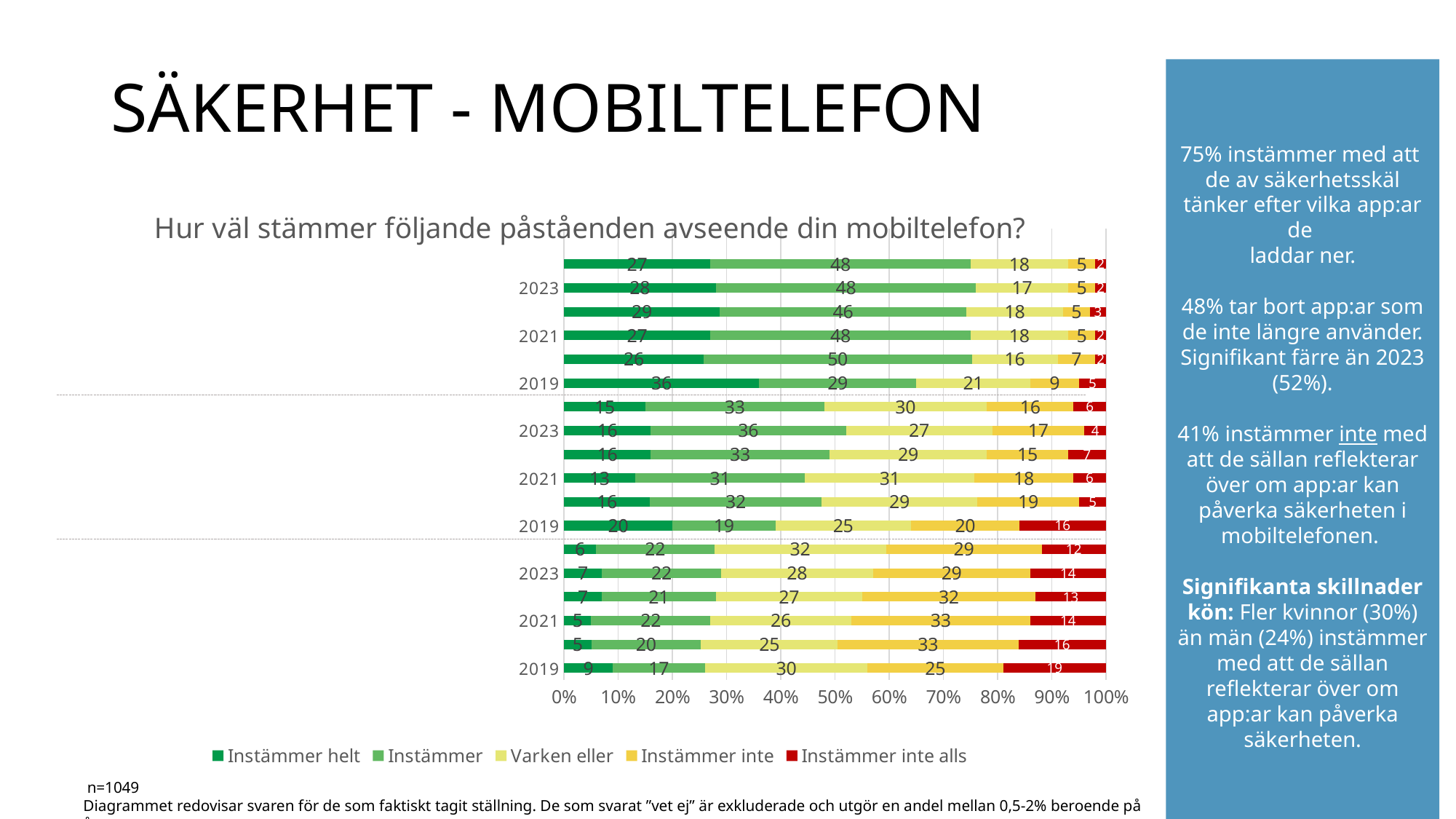
In the top group of bars, what is the 'Instämmer' value for 2023? 48 In the middle group of bars, what is the difference between the 'Instämmer inte alls' values for 2019 and 2023? 12 How many stacked bars are plotted in the chart in total? 18 In the bottom group of bars, what is the 'Instämmer inte alls' value for 2019? 19 Which legend entry is shown in dark red? Instämmer inte alls In the top group of bars, which is larger for 2019: 'Instämmer helt' or 'Instämmer'? Instämmer helt In the bottom group of bars, what is the 'Instämmer inte' value for 2021? 33 In the bottom group of bars, which year has the highest 'Instämmer inte alls' value? 2019 In the middle group of bars, what is the 'Varken eller' value for 2021? 31 How many series does the legend list? 5 What kind of chart is shown on the slide? Stacked bar chart In the top group of bars, what is the 'Instämmer helt' value for 2019? 36